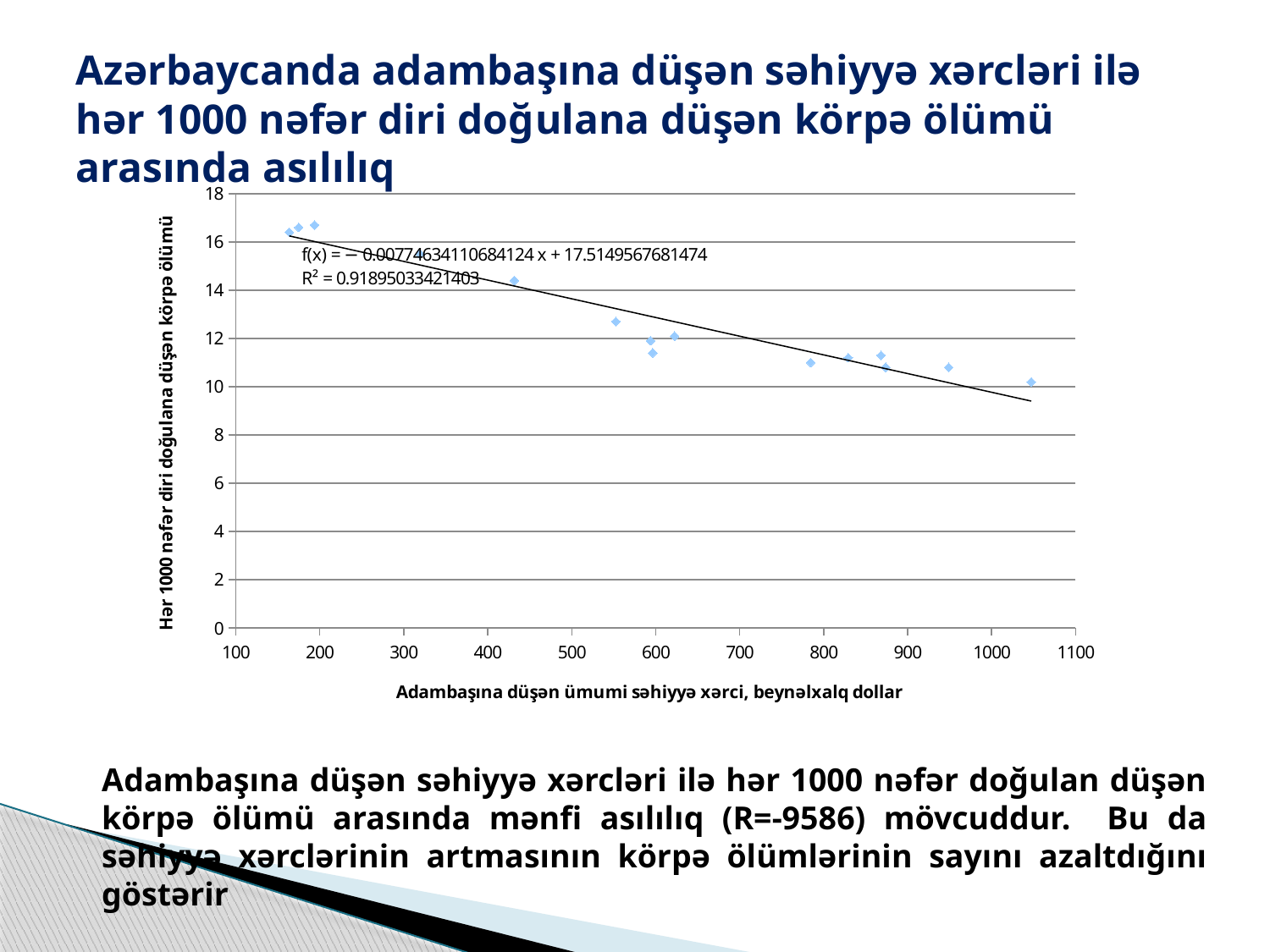
Is the infant mortality value for the point near 950 international dollars greater or less than 12? less As per-capita health spending increases along the x axis, does infant mortality rise or fall? fall Which has the higher infant mortality: the points near 200 international dollars or the point near 1050 international dollars? the points near 200 international dollars What is the intercept in the trendline equation printed on the chart? 17.5149567681474 What kind of chart is shown on the slide? scatter chart Is the infant mortality value for the point near 430 international dollars greater or less than 12? greater Is the infant mortality value for the points near 200 international dollars greater or less than 16? greater What is the R² value printed on the chart? R² = 0.91895033421403 What is the maximum value shown on the y axis? 18